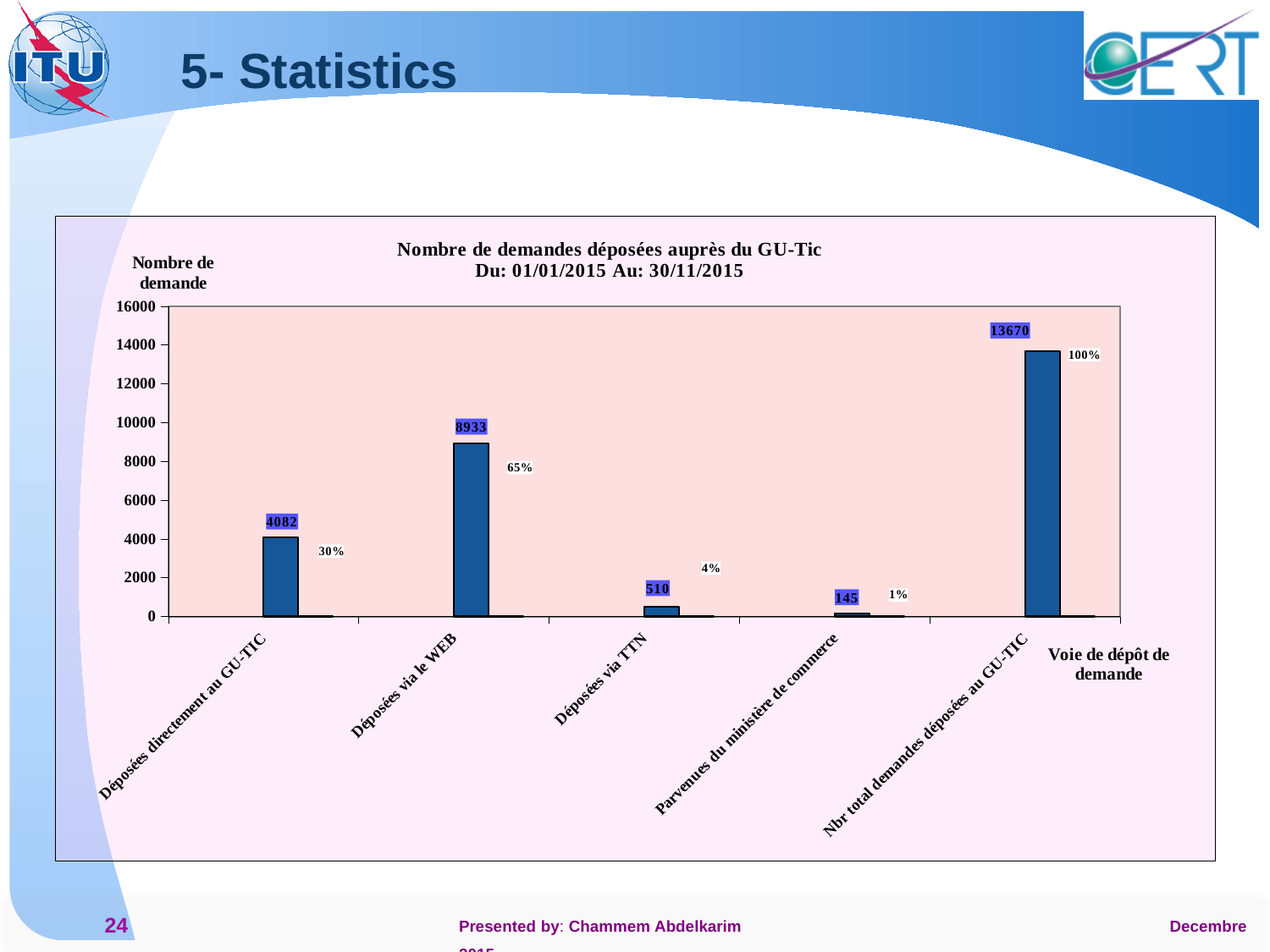
Which category has the lowest value? Parvenues du ministère de commerce What is the difference between the values for 'Déposées via le WEB' and 'Déposées directement au GU-TIC'? 4851 How many categories are shown on the x axis? 5 Which is larger, the value for 'Déposées via TTN' or the value for 'Parvenues du ministère de commerce'? Déposées via TTN What kind of chart is this? Bar chart What date range is given in the chart title? Du: 01/01/2015 Au: 30/11/2015 What is the value for 'Déposées via le WEB'? 8933 What is the value for 'Déposées directement au GU-TIC'? 4082 What percentage is shown next to the 'Déposées via le WEB' bar? 65% What is the value for 'Parvenues du ministère de commerce'? 145 Which category has the highest value? Nbr total demandes déposées au GU-TIC What is the value for 'Déposées via TTN'? 510